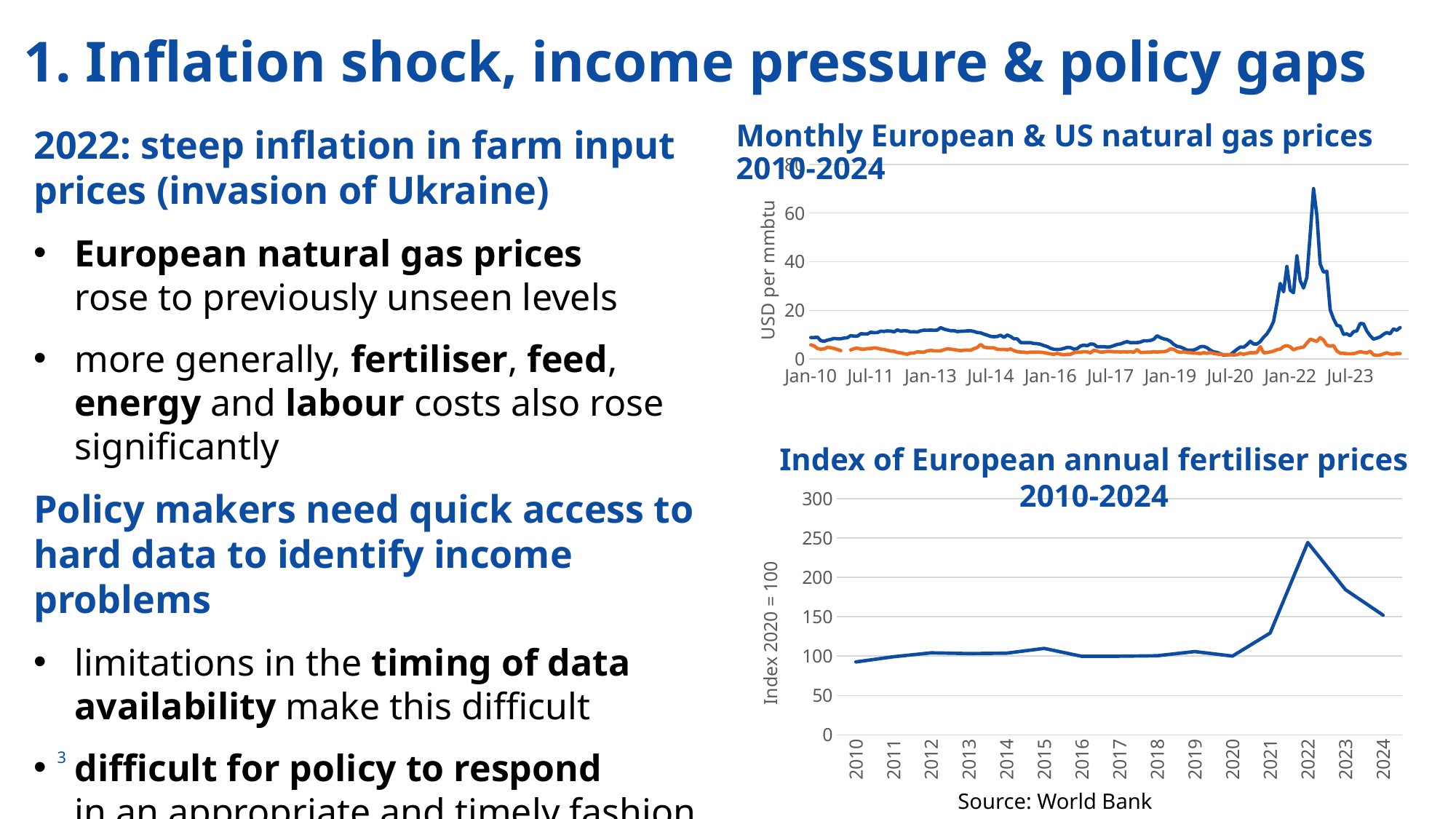
What kind of chart is the 'Index of European annual fertiliser prices 2010-2024' chart? line chart What kind of chart is the 'Monthly European & US natural gas prices 2010-2024' chart? line chart In the 'Index of European annual fertiliser prices 2010-2024' chart, which year has the larger value, 2022 or 2023? 2022 In the 'Index of European annual fertiliser prices 2010-2024' chart, is the value for 2022 greater or less than 200? greater In the 'Index of European annual fertiliser prices 2010-2024' chart, do the values rise or fall from 2022 to 2024? fall What is the y-axis label of the 'Monthly European & US natural gas prices 2010-2024' chart? USD per mmbtu In the 'Index of European annual fertiliser prices 2010-2024' chart, which year has the highest index value? 2022 What is the y-axis label of the 'Index of European annual fertiliser prices 2010-2024' chart? Index 2020 = 100 In the 'Index of European annual fertiliser prices 2010-2024' chart, how many years are shown on the x axis? 15 In the 'Monthly European & US natural gas prices 2010-2024' chart, is the peak value of the blue line greater or less than 60? greater In the 'Index of European annual fertiliser prices 2010-2024' chart, is the value for 2010 greater or less than 100? less